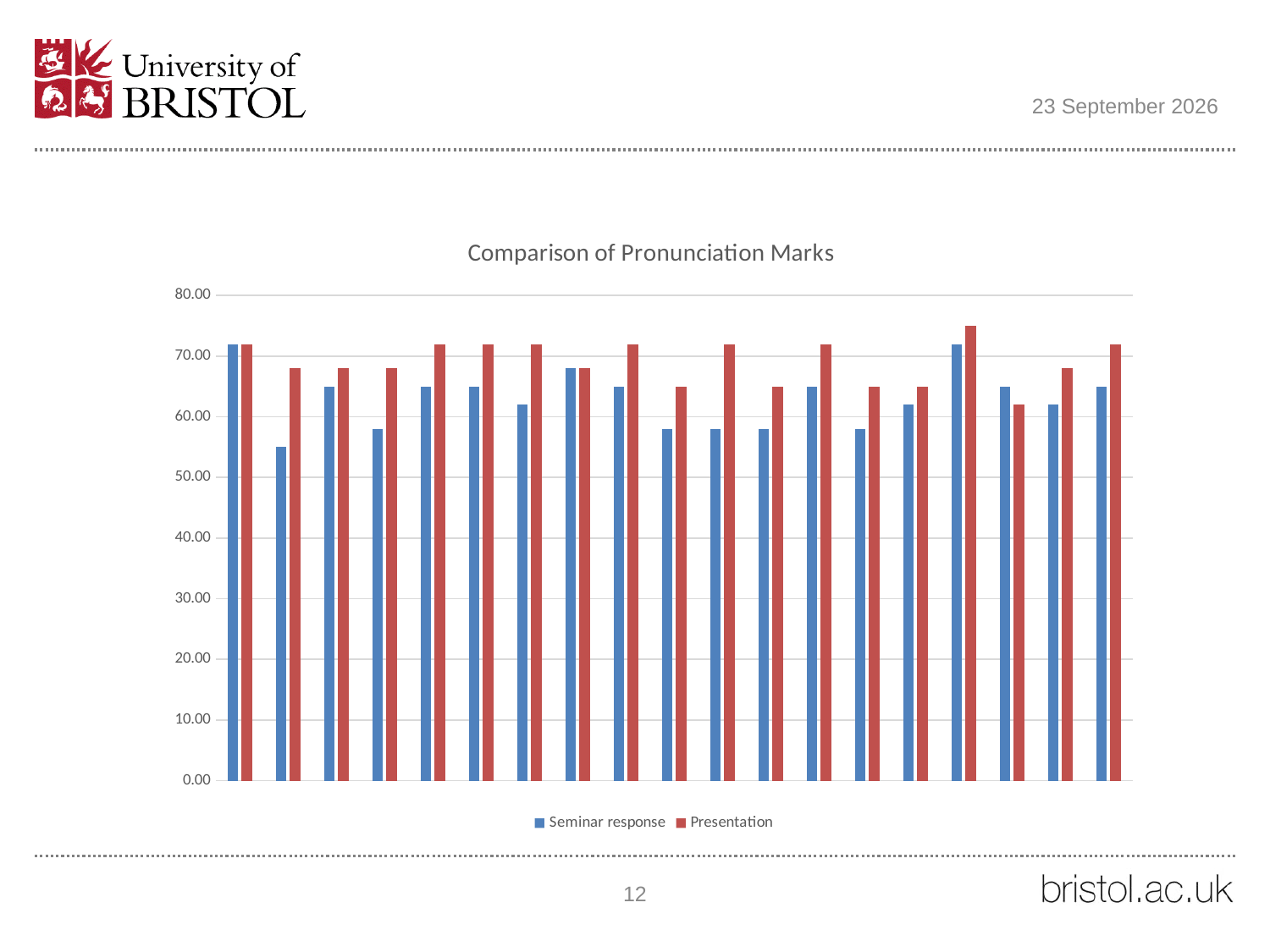
What kind of chart is shown on the slide? Bar chart Is the Presentation value for the leftmost group of bars greater or less than 70? greater How many series does the legend list? 2 In the second group of bars from the left, which is larger, Seminar response or Presentation? Presentation What are the two series named in the legend? Seminar response and Presentation What is the title of the chart? Comparison of Pronunciation Marks How many groups of bars are plotted along the x axis? 19 What is the highest value shown on the vertical axis? 80.00 Is the Seminar response value for the leftmost group of bars greater or less than 60? greater Which series contains the tallest bar in the chart? Presentation Is the tallest Presentation bar greater or less than 70? greater